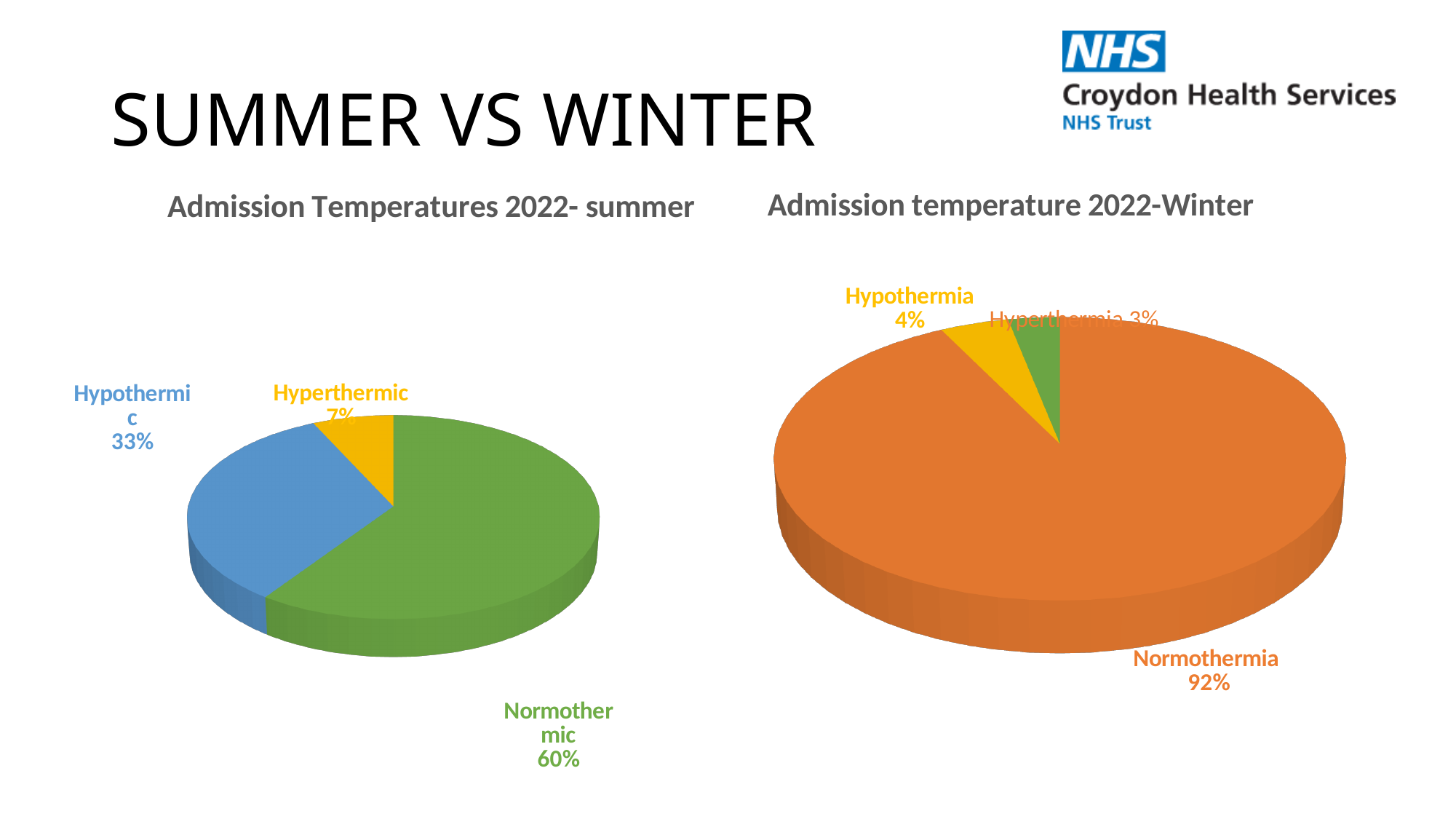
In the 'Admission Temperatures 2022- summer' chart, what share is Hypothermic? 33% In the 'Admission temperature 2022-Winter' chart, which category has the largest slice? Normothermia What kind of chart is the 'Admission temperature 2022-Winter' chart? Pie chart How many slices does the 'Admission Temperatures 2022- summer' chart have? 3 In the 'Admission temperature 2022-Winter' chart, what share is Hypothermia? 4% In the 'Admission Temperatures 2022- summer' chart, what share is Normothermic? 60% In the 'Admission Temperatures 2022- summer' chart, what share is Hyperthermic? 7% In the 'Admission temperature 2022-Winter' chart, what share is Hyperthermia? 3% In the 'Admission Temperatures 2022- summer' chart, which category has the smallest slice? Hyperthermic In the 'Admission temperature 2022-Winter' chart, what share is Normothermia? 92% In the 'Admission Temperatures 2022- summer' chart, which category has the largest slice? Normothermic In the 'Admission Temperatures 2022- summer' chart, what is the difference between the Hypothermic and Hyperthermic shares? 26%